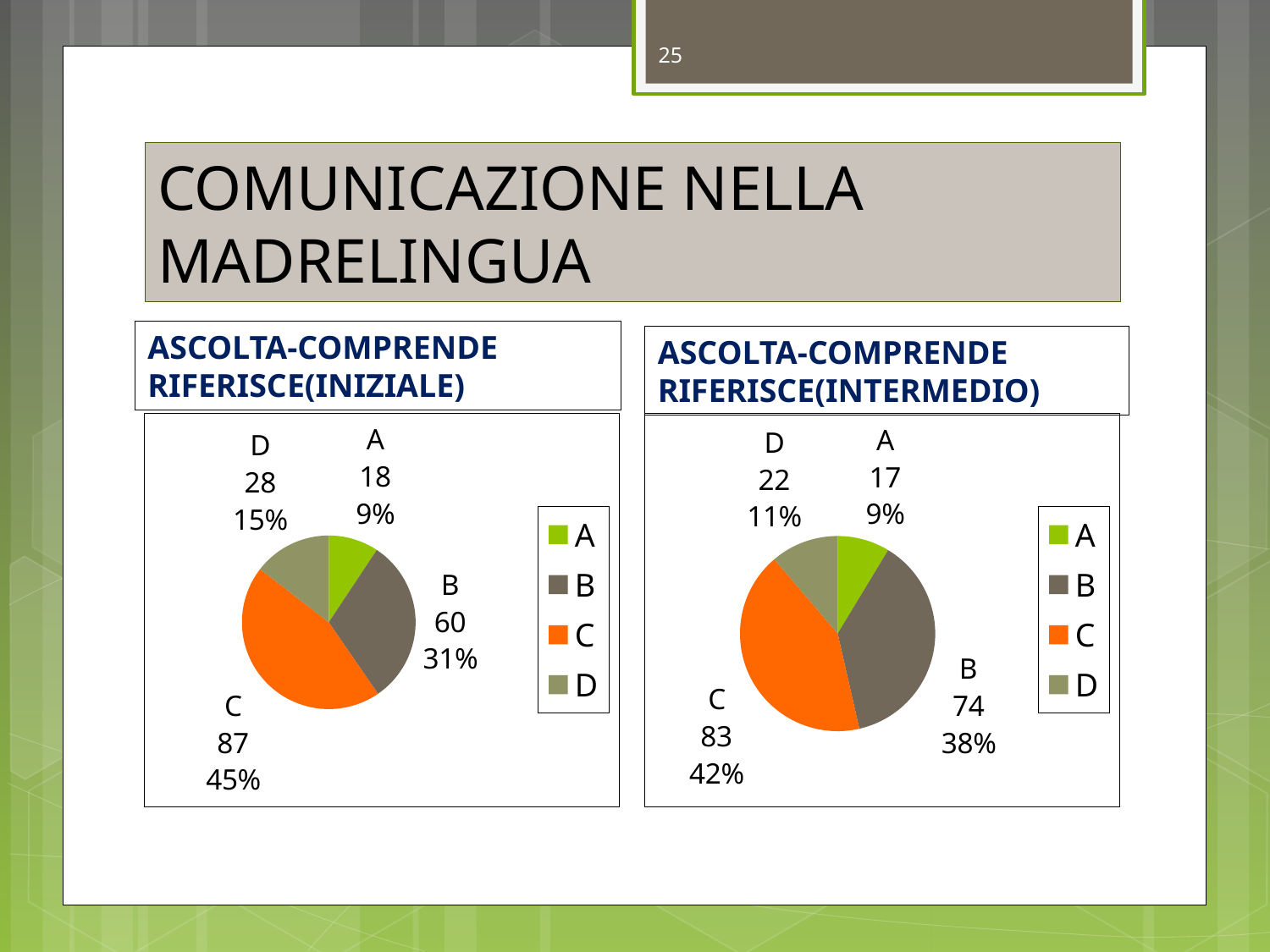
In the right pie chart (INTERMEDIO), which is larger, the value for B or the value for D? B In the right pie chart (INTERMEDIO), what is the difference between the values for D and A? 5 In the left pie chart (INIZIALE), what is the value for category C? 87 In the left pie chart (INIZIALE), what is the difference between the values for C and B? 27 In the right pie chart (INTERMEDIO), which category has the smallest value? A What is the title of the chart on the left? ASCOLTA-COMPRENDE RIFERISCE(INIZIALE) In the right pie chart (INTERMEDIO), what percentage share does category C have? 42% In the right pie chart (INTERMEDIO), what is the value for category B? 74 What type of chart is used on the right (INTERMEDIO)? Pie chart In the left pie chart (INIZIALE), which category has the largest value? C In the left pie chart (INIZIALE), what percentage share does category D have? 15% How many categories does the left pie chart (INIZIALE) show? 4